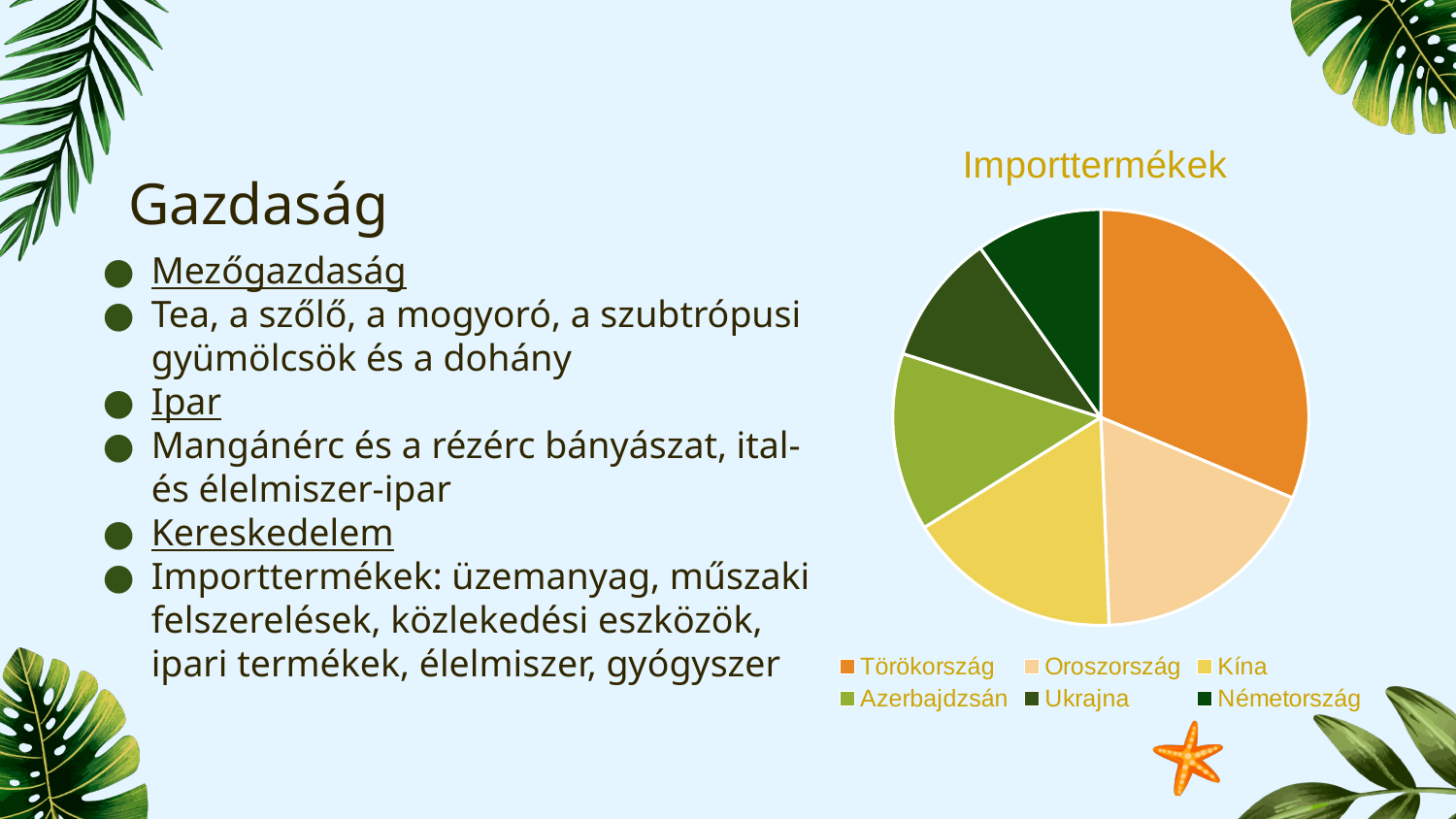
Which slice is larger, Törökország or Ukrajna? Törökország What is the title of the pie chart? Importtermékek Which slice is larger, Kína or Németország? Kína What kind of chart is shown on the slide? pie chart Which country has the largest slice in the pie chart? Törökország Which country is represented by the orange slice in the pie chart? Törökország How many slices does the pie chart have? 6 Which slice is larger, Törökország or Oroszország? Törökország How many entries does the legend of the pie chart list? 6